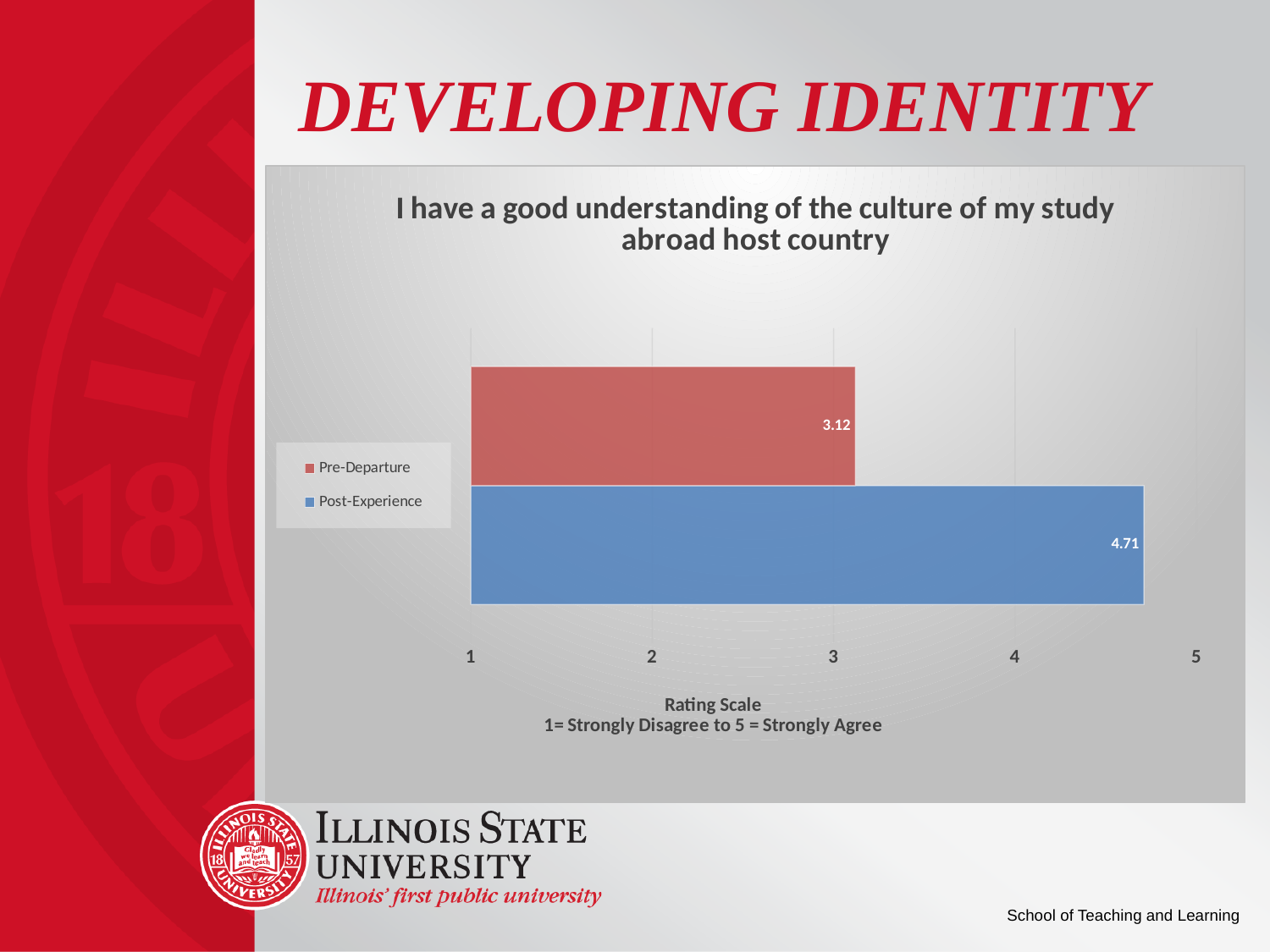
What colour is the Post-Experience bar? Blue Which series has the higher value, Pre-Departure or Post-Experience? Post-Experience Is the Pre-Departure value greater or less than 3? greater What is the Pre-Departure value in the chart? 3.12 What kind of chart is shown on the slide? Bar chart How many series does the legend list? 2 Which series has the lowest value in the chart? Pre-Departure Is the Post-Experience value greater or less than 4? greater What is the difference between the Post-Experience and Pre-Departure values? 1.59 What is the title of the chart? I have a good understanding of the culture of my study abroad host country What is the Post-Experience value in the chart? 4.71 What is the maximum value shown on the rating scale axis? 5